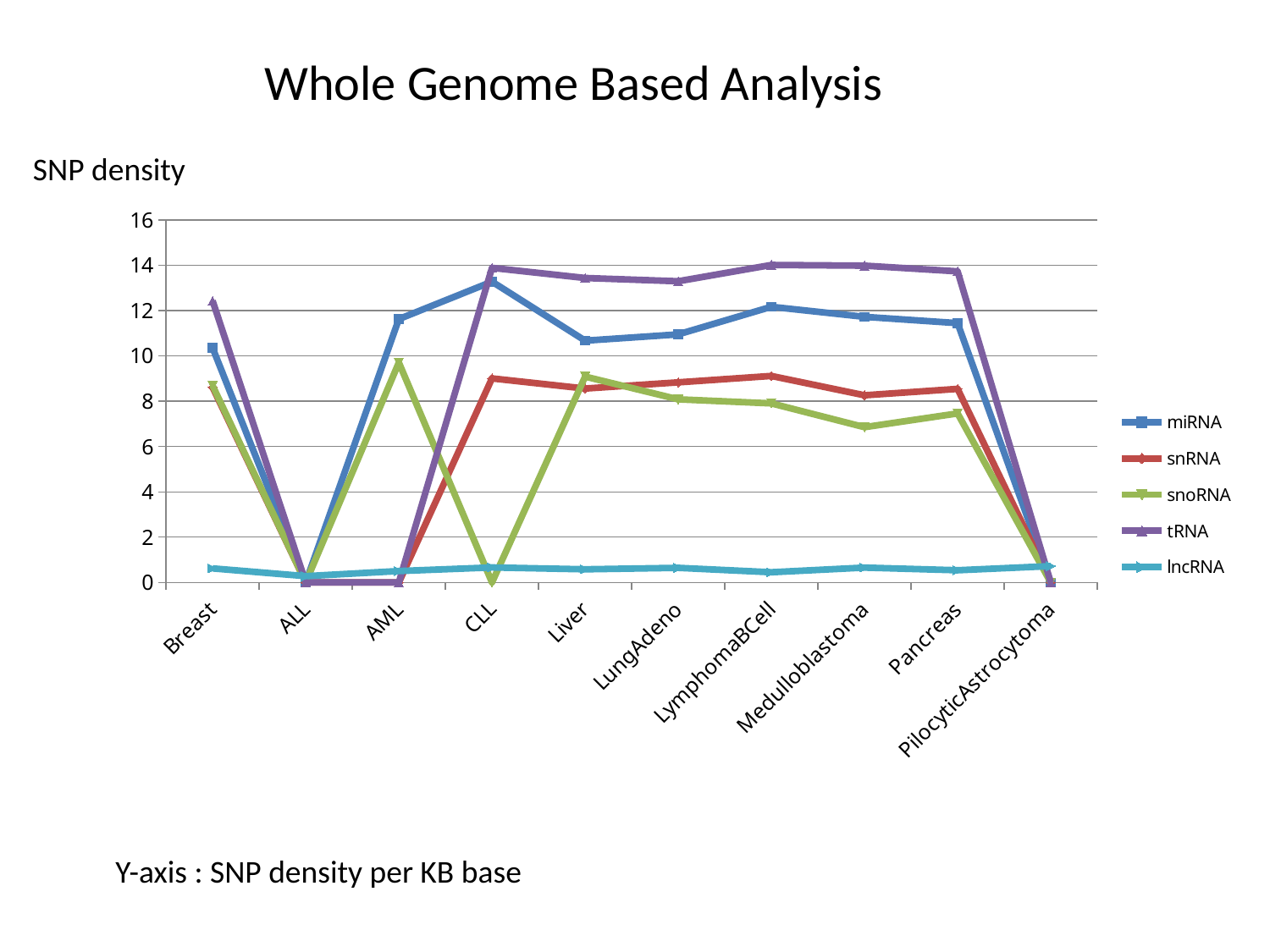
Is the tRNA value for LymphomaBCell greater or less than 12? greater At AML, which series has the larger value, snoRNA or snRNA? snoRNA At Liver, which series has the larger value, miRNA or snRNA? miRNA Which series has the lowest value at Breast? lncRNA Is the snoRNA value for Medulloblastoma greater or less than 8? less How many series does the legend list? 5 Is the miRNA value for Liver greater or less than 12? less Which series has the highest value at Medulloblastoma? tRNA What kind of chart is shown on the slide? line chart How many categories are shown along the x axis? 10 Which series is shown in purple in the legend? tRNA